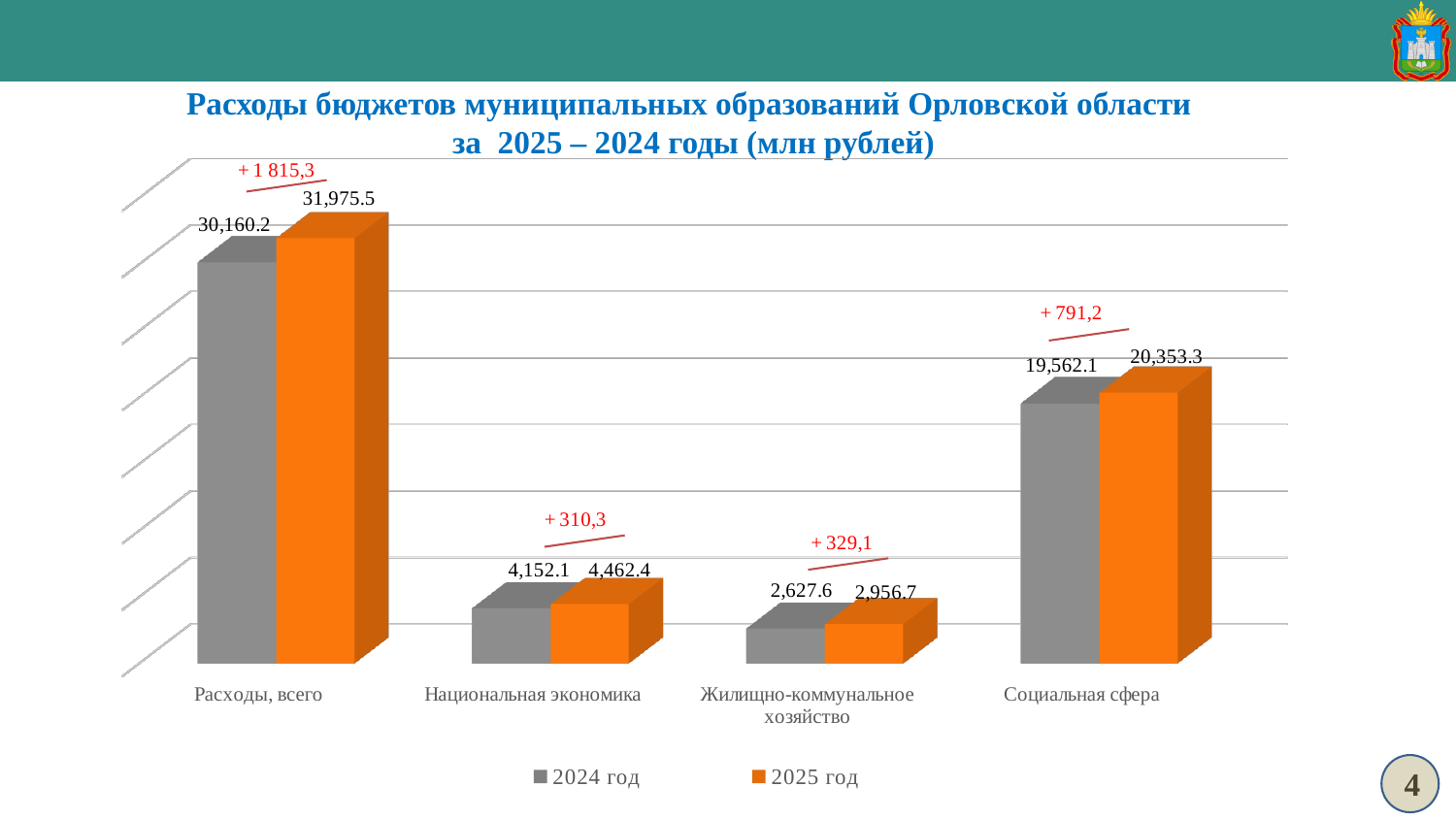
How many series does the legend list? 2 What kind of chart is shown on the slide? Bar chart What is the value for Жилищно-коммунальное хозяйство in the 2025 год series? 2,956.7 Which is larger for Жилищно-коммунальное хозяйство: the 2024 год value or the 2025 год value? 2025 год What is the value for Социальная сфера in the 2024 год series? 19,562.1 Which category has the highest value in the 2025 год series? Расходы, всего Which category has the lowest value in the 2024 год series? Жилищно-коммунальное хозяйство How many categories are shown on the x axis? 4 What is the value for Национальная экономика in the 2024 год series? 4,152.1 What is the difference between the 2025 год and 2024 год values for Социальная сфера? 791.2 What is the difference between the 2025 год and 2024 год values for Национальная экономика? 310.3 What is the value for Расходы, всего in the 2025 год series? 31,975.5